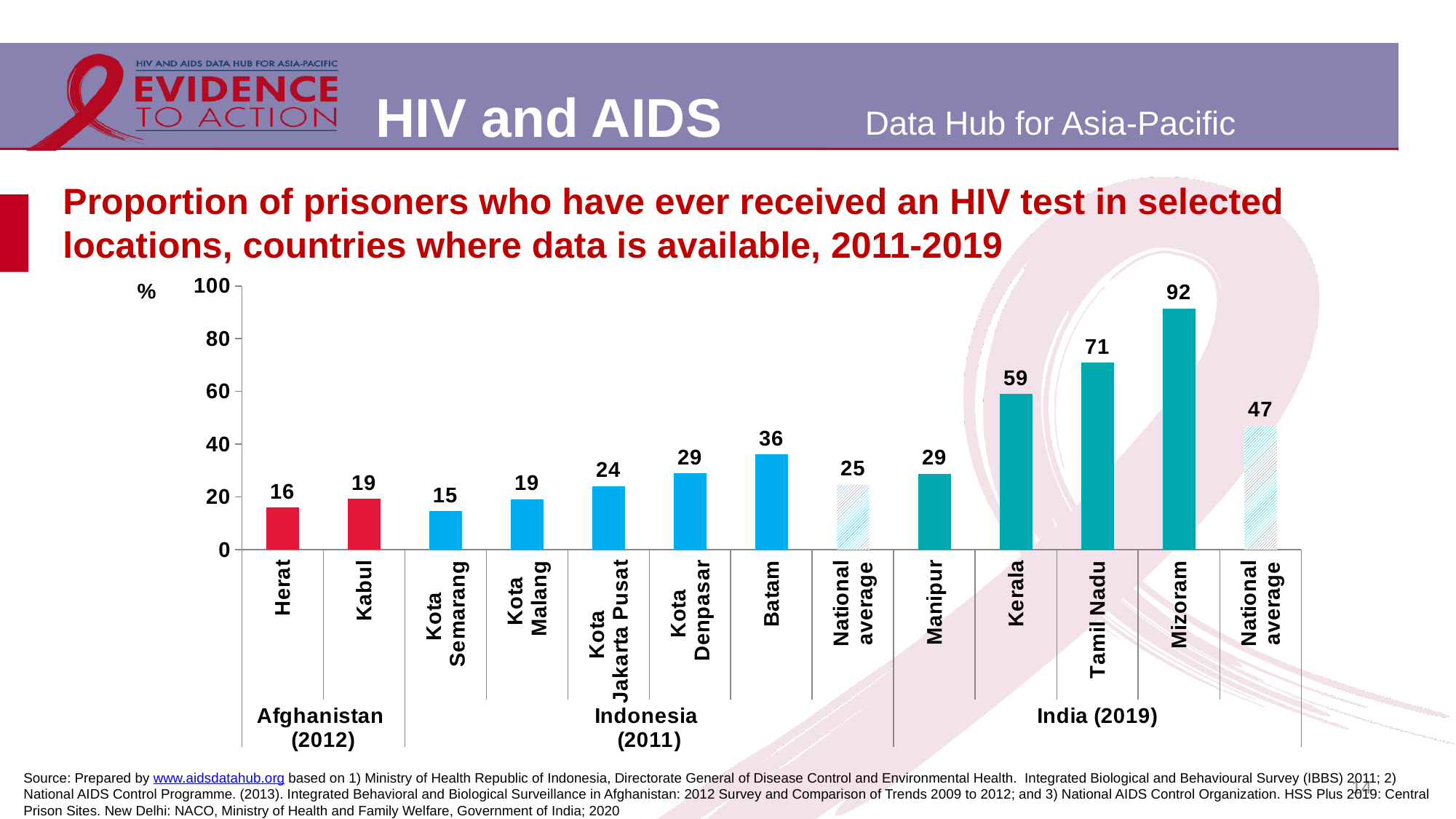
What is the difference between the values for Tamil Nadu and Kerala? 12 Which location has the highest proportion of prisoners who have ever received an HIV test? Mizoram What is the value for Mizoram? 92 Which location has the lowest proportion of prisoners who have ever received an HIV test? Kota Semarang What is the value for Herat in Afghanistan (2012)? 16 What is the value for Batam in Indonesia (2011)? 36 Which is larger, the value for Kota Denpasar or the value for Kota Jakarta Pusat? Kota Denpasar Is the value for Kerala greater or less than 40? greater How many countries are grouped along the x axis of the chart? 3 How many bars are plotted in the chart? 13 What kind of chart is shown on the slide? Bar chart What is the national average for India (2019)? 47